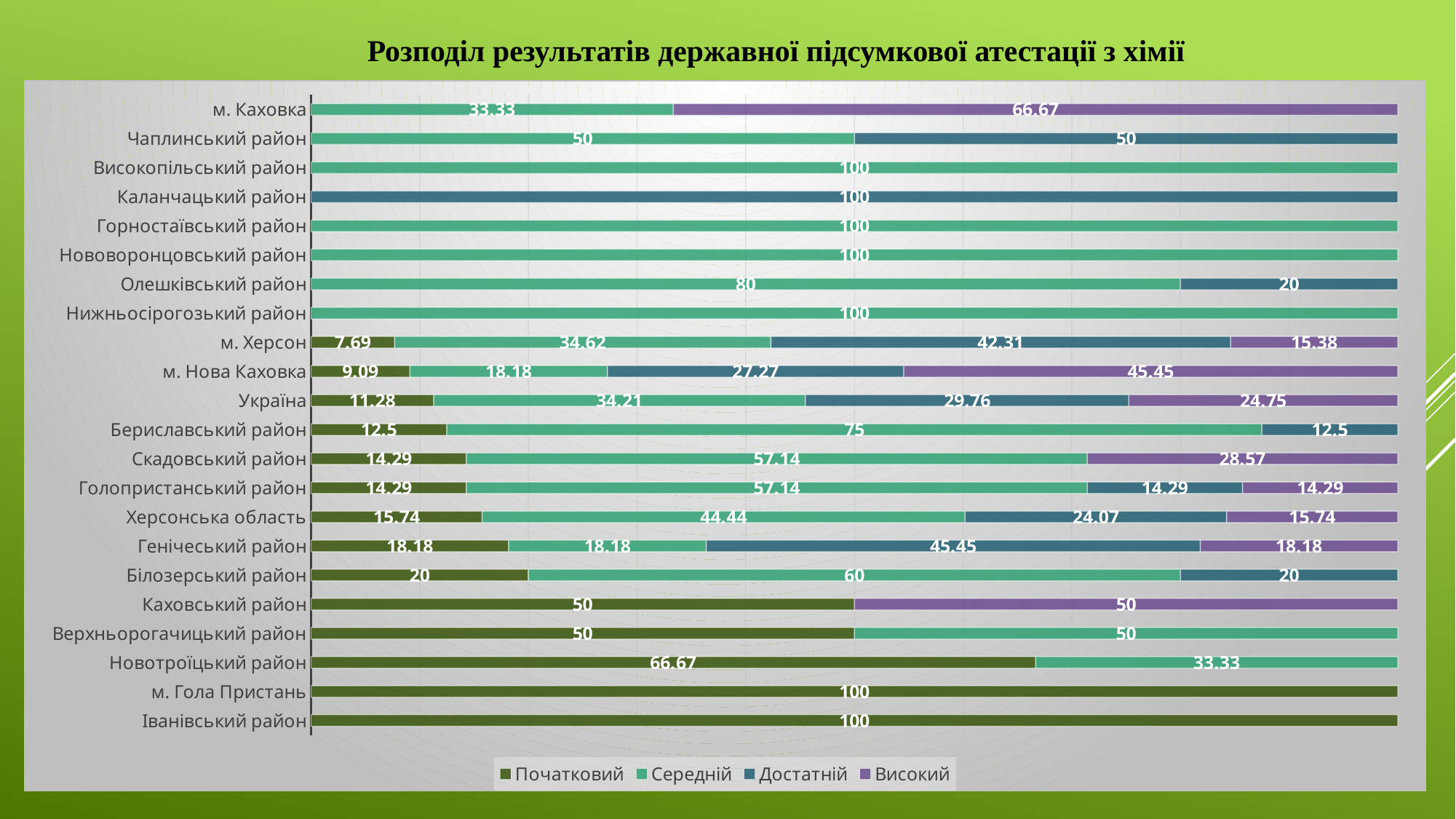
What is the value of the Початковий series for Україна? 11.28 What type of chart is shown on the slide? Stacked bar chart What is the value of the Високий series for м. Каховка? 66.67 For Генічеський район, which series has the highest value? Достатній What is the value of the Достатній series for м. Херсон? 42.31 For м. Херсон, which is larger: the Достатній value or the Середній value? Достатній What is the value of the Середній series for Херсонська область? 44.44 How many categories (regions) are plotted on the chart? 22 For Україна, what is the difference between the Середній value and the Достатній value? 4.45 What are the four legend entries of the chart? Початковий, Середній, Достатній, Високий How many series does the legend list? 4 What is the value of the Високий series for м. Нова Каховка? 45.45